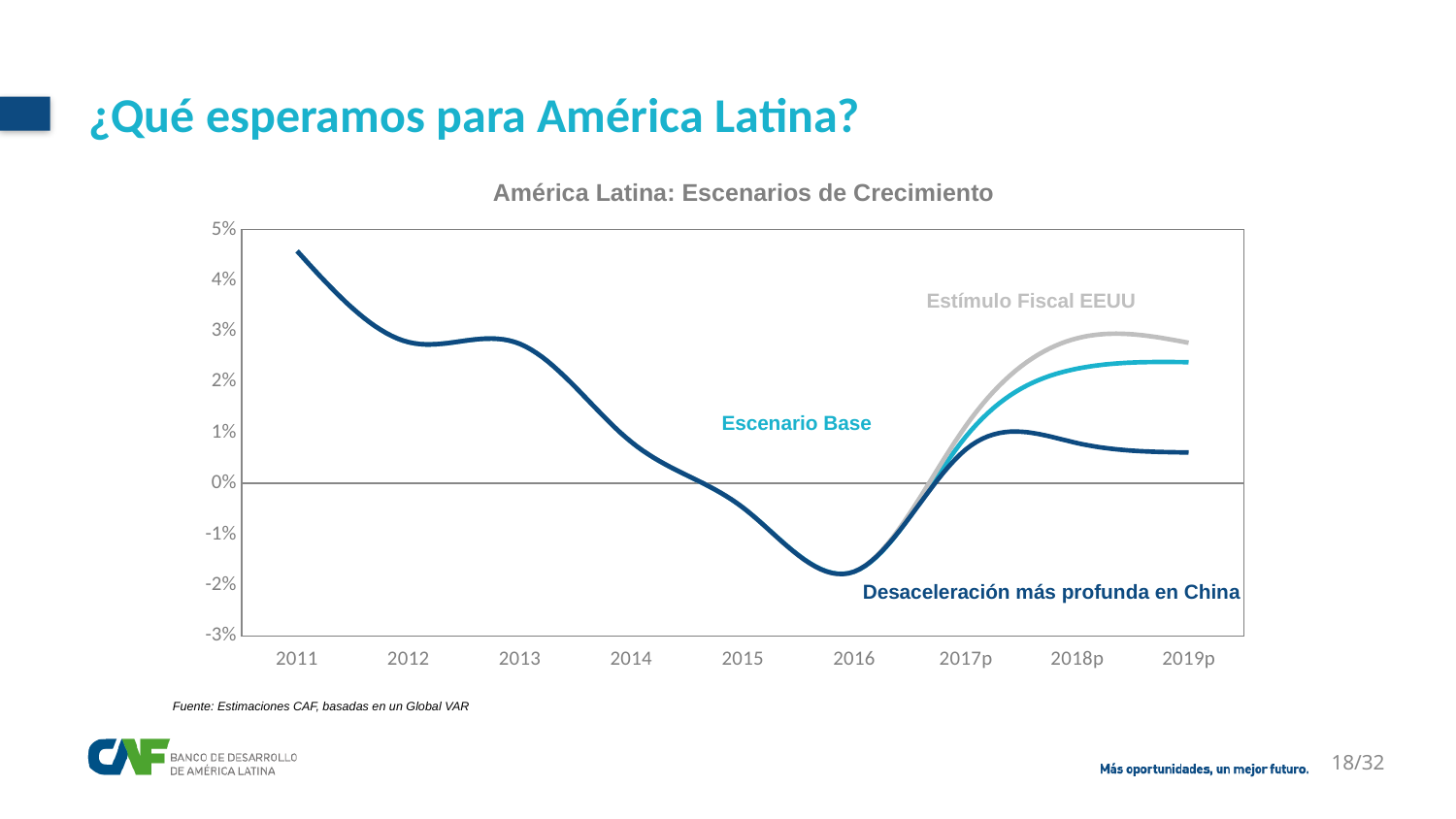
Does growth rise or fall between 2011 and 2016? Fall How many years are labelled on the x axis of the chart? 9 In 2019p, which is higher: the Estímulo Fiscal EEUU scenario or the Escenario Base? Estímulo Fiscal EEUU What kind of chart is shown on the slide? Line chart Is the value for 2016 greater or less than -1%? less In which year does the growth line reach its lowest point? 2016 Which scenario shows the highest growth in 2019p? Estímulo Fiscal EEUU Which scenario shows the lowest growth in 2019p? Desaceleración más profunda en China Is the value for 2011 greater or less than 4%? greater How many scenarios are labelled on the chart? 3 Is the value of the Desaceleración más profunda en China scenario in 2019p greater or less than 1%? less What is the title of the chart? América Latina: Escenarios de Crecimiento